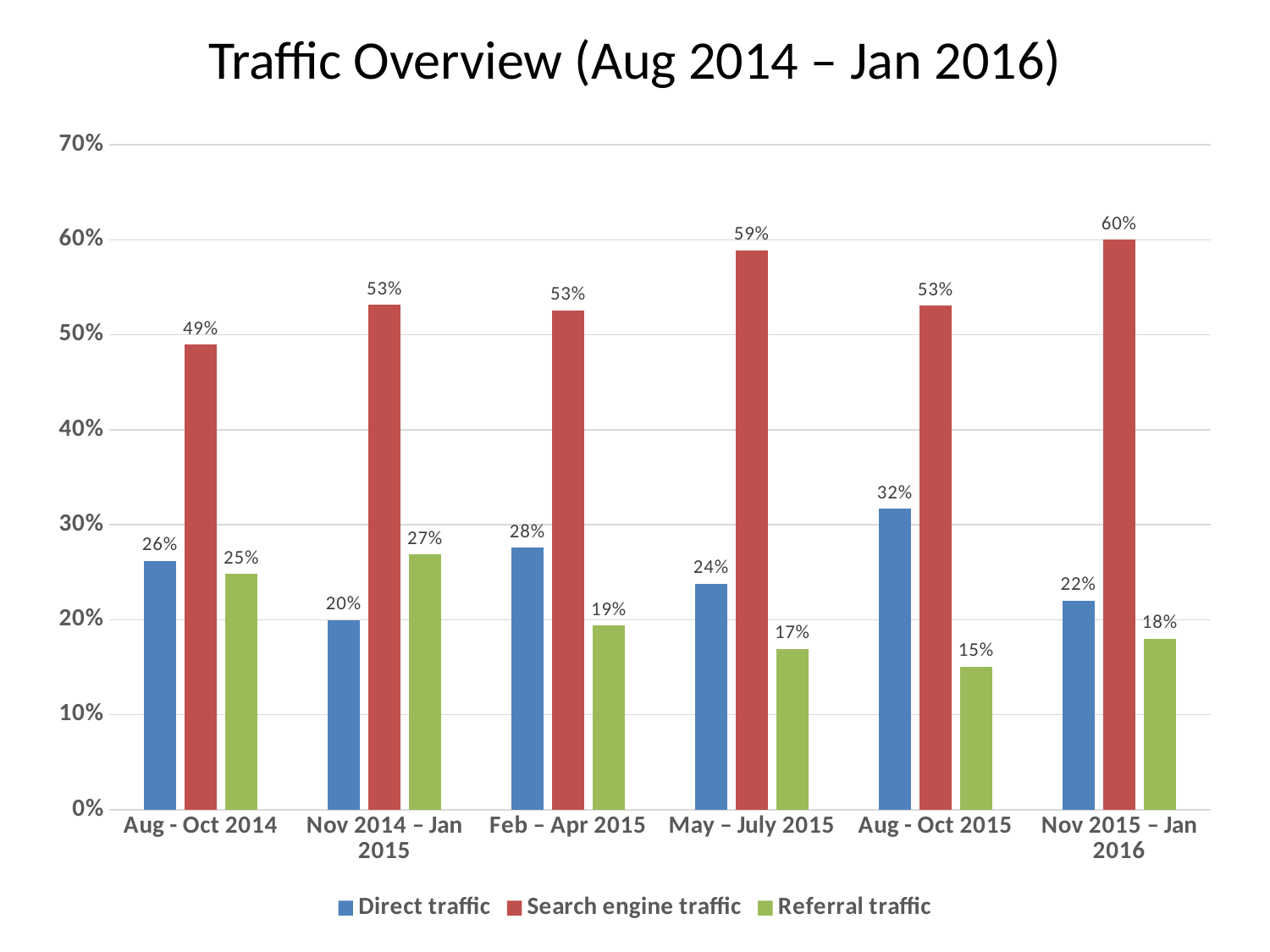
What colour represents Referral traffic in the chart? Green Which period has the highest Search engine traffic? Nov 2015 – Jan 2016 Which is larger in Aug - Oct 2014: Direct traffic or Referral traffic? Direct traffic How many series does the legend list? 3 What kind of chart is shown on the slide? Bar chart Which period has the lowest Referral traffic? Aug - Oct 2015 What is the difference between Search engine traffic and Direct traffic in May – July 2015? 35% What is the Referral traffic value for May – July 2015? 17% What is the Search engine traffic value for Nov 2015 – Jan 2016? 60% What is the Direct traffic value for Aug - Oct 2015? 32% Is the Search engine traffic value for Aug - Oct 2014 greater or less than 40%? greater How many time periods are shown on the x axis? 6